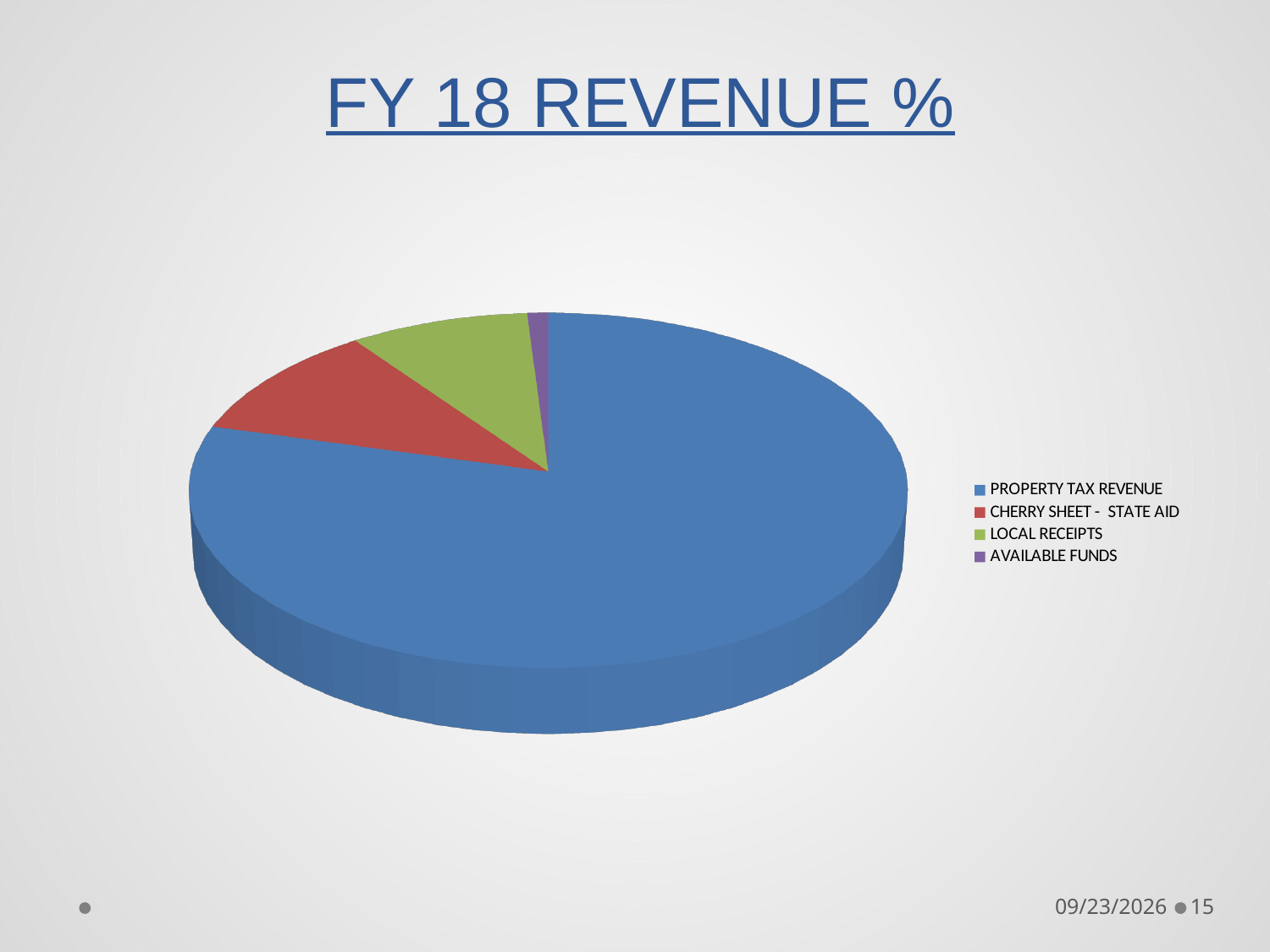
How many categories (slices) does the pie chart have? 4 Which is larger, CHERRY SHEET - STATE AID or AVAILABLE FUNDS? CHERRY SHEET - STATE AID Which category has the largest share of the pie? PROPERTY TAX REVENUE What is the title of the chart? FY 18 REVENUE % Which category has the smallest share of the pie? AVAILABLE FUNDS How many entries does the legend list? 4 What kind of chart is shown on the slide? Pie chart Which is larger, LOCAL RECEIPTS or AVAILABLE FUNDS? LOCAL RECEIPTS Which is larger, PROPERTY TAX REVENUE or CHERRY SHEET - STATE AID? PROPERTY TAX REVENUE What colour represents PROPERTY TAX REVENUE in the pie chart? Blue